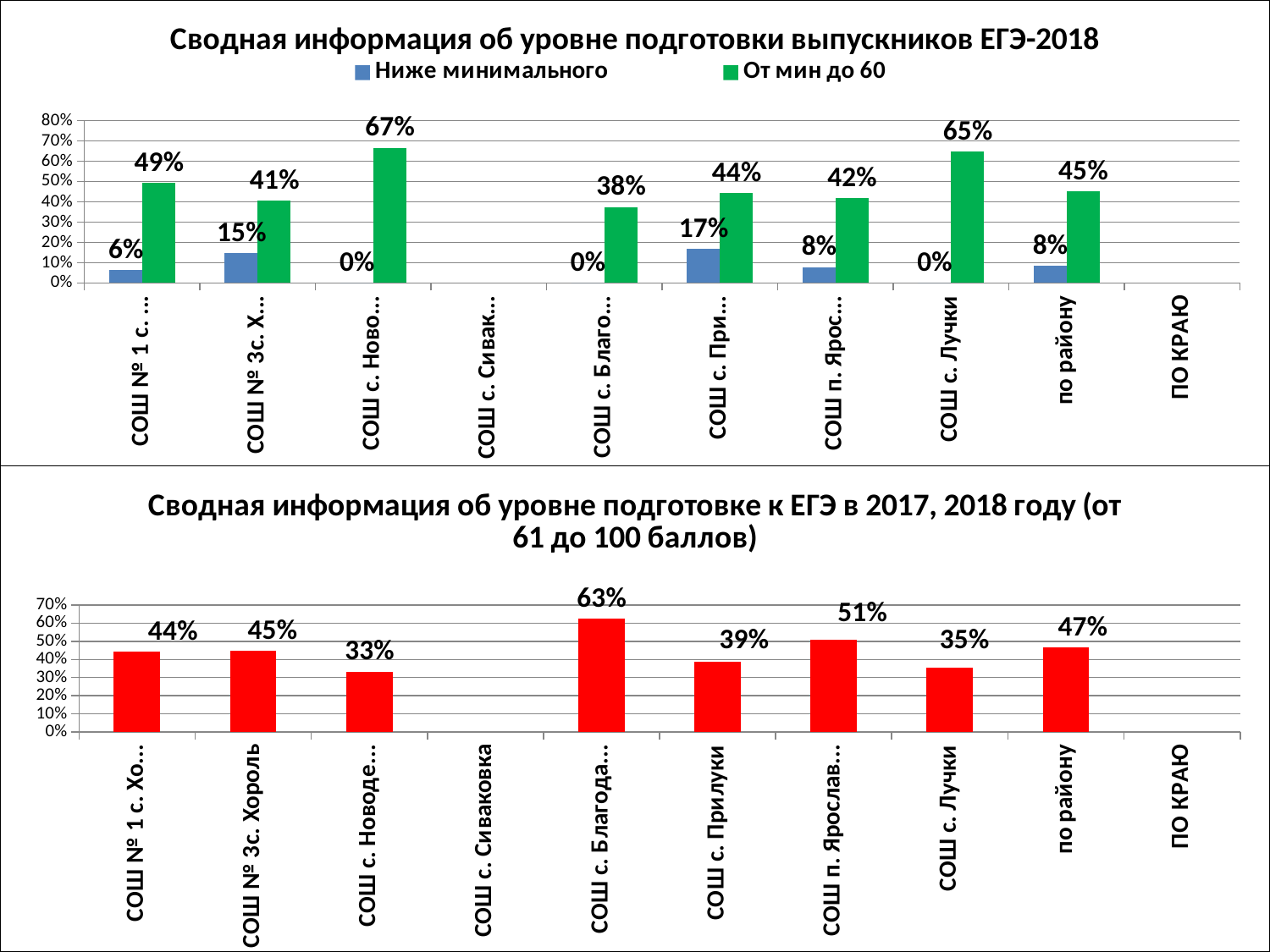
In the bottom chart (от 61 до 100 баллов), what is the value for 'по району'? 47% In the top chart (ЕГЭ-2018), what is the value of 'Ниже минимального' for 'по району'? 8% In the top chart (ЕГЭ-2018), what is the difference between the 'От мин до 60' and 'Ниже минимального' values for 'по району'? 37% In the bottom chart (от 61 до 100 баллов), what is the difference between the values for СОШ с. Лучки and 'по району'? 12% What type of chart is the bottom chart (от 61 до 100 баллов)? Bar chart In the top chart (ЕГЭ-2018), what is the value of 'От мин до 60' for СОШ с. Лучки? 65% In the top chart (ЕГЭ-2018), what colour are the 'Ниже минимального' bars? Blue In the top chart (ЕГЭ-2018), which category has the highest 'От мин до 60' value? СОШ с. Ново... (67%) In the bottom chart (от 61 до 100 баллов), which is larger: the value for СОШ с. Лучки or for СОШ № 3с. Хороль? СОШ № 3с. Хороль In the bottom chart (от 61 до 100 баллов), what is the value for СОШ с. Прилуки? 39% In the bottom chart (от 61 до 100 баллов), which category has the highest value? СОШ с. Благода... (63%) In the top chart (ЕГЭ-2018), how many series does the legend list? 2